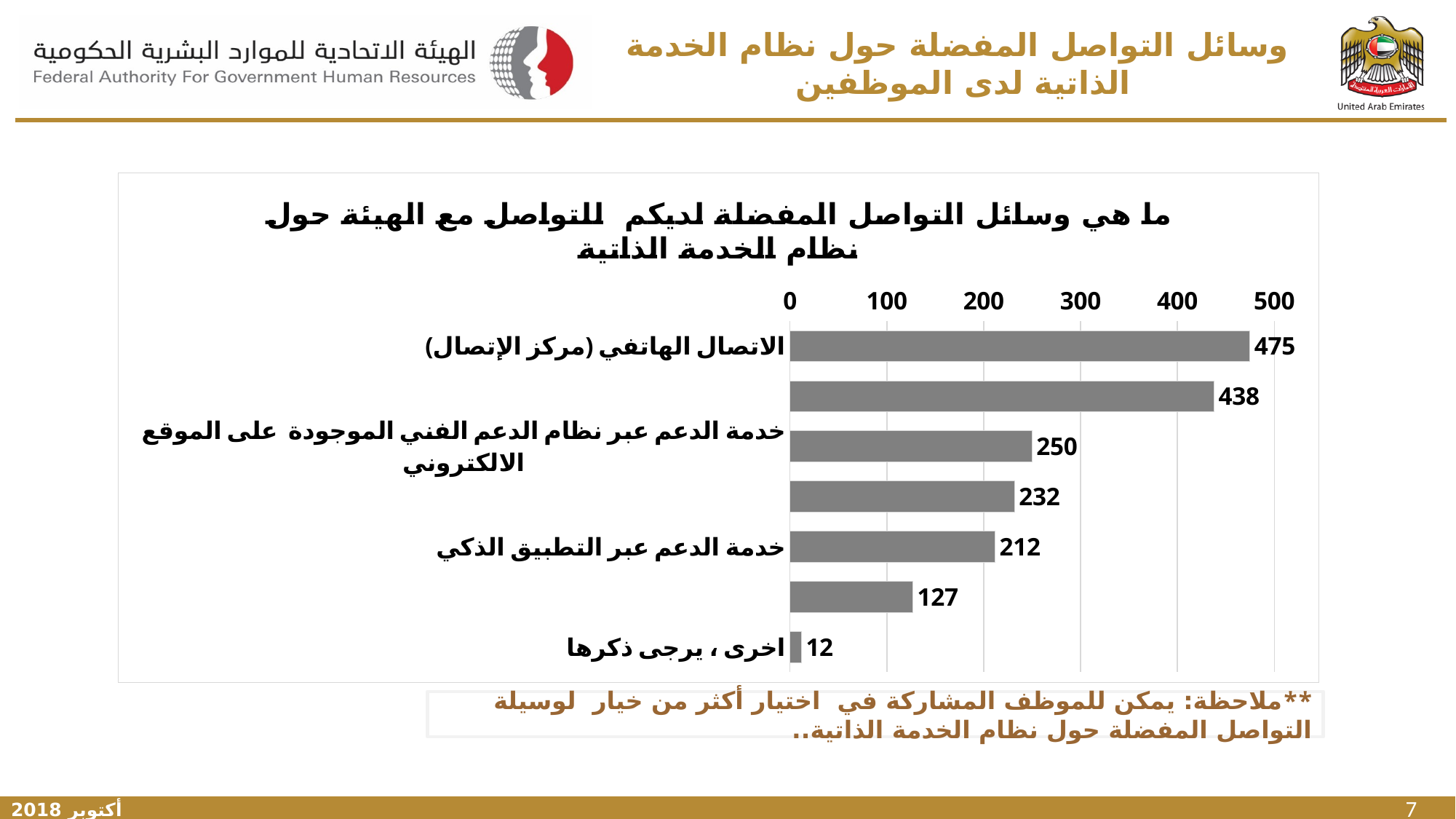
What is the highest value shown on the chart's axis? 500 Which category has the lowest value? اخرى ، يرجى ذكرها What is the value for اخرى ، يرجى ذكرها? 12 How many bars are plotted in the chart? 7 What is the value for خدمة الدعم عبر التطبيق الذكي? 212 What kind of chart is shown on the slide? Bar chart Which is larger: the value for خدمة الدعم عبر التطبيق الذكي or the value for اخرى ، يرجى ذكرها? خدمة الدعم عبر التطبيق الذكي What is the value for خدمة الدعم عبر نظام الدعم الفني الموجودة على الموقع الالكتروني? 250 Which category has the highest value? الاتصال الهاتفي (مركز الإتصال) What is the difference between the values for الاتصال الهاتفي (مركز الإتصال) and خدمة الدعم عبر التطبيق الذكي? 263 What is the difference between the values for خدمة الدعم عبر نظام الدعم الفني الموجودة على الموقع الالكتروني and خدمة الدعم عبر التطبيق الذكي? 38 What is the value for الاتصال الهاتفي (مركز الإتصال)? 475